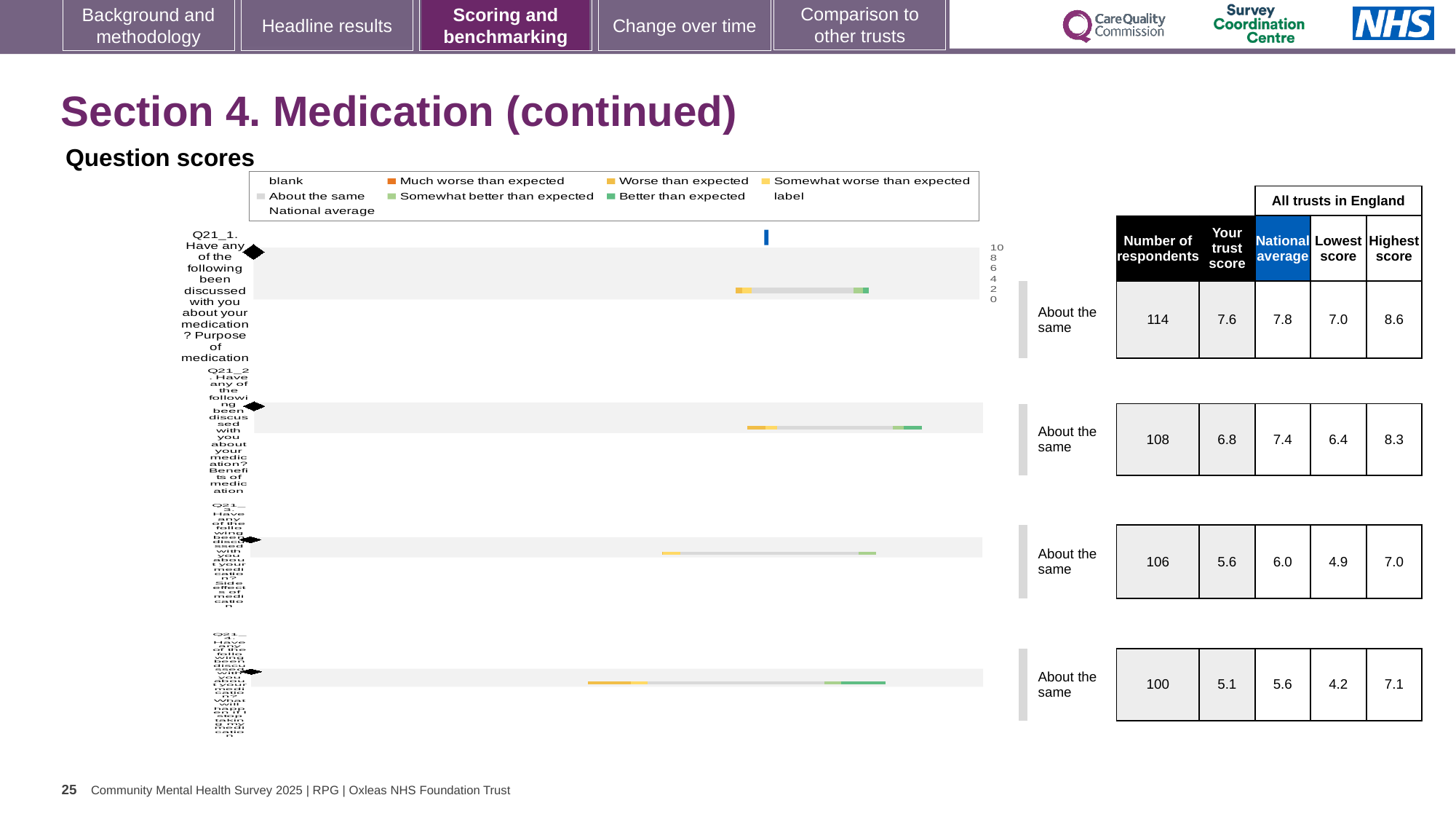
How many question bars (Q21_1 to Q21_4) are plotted in the chart? 4 What benchmark category is shown next to each of the four question bars? About the same In the table beside the chart, what is the highest score for Q21_4? 7.1 For Q21_3, which is larger in the table beside the chart: 'Your trust score' or the national average? National average In the table beside the chart, what is 'Your trust score' for Q21_2 (Benefits of medication)? 6.8 What is the difference between the national average and 'Your trust score' for Q21_2 in the table beside the chart? 0.6 Which question has the highest 'Your trust score' in the table beside the chart? Q21_1 What kind of chart is shown under 'Question scores'? bar chart In the table beside the chart, what is the lowest score for Q21_1? 7.0 In the table beside the chart, what is the national average for Q21_3? 6.0 In the table beside the chart, what is the number of respondents for Q21_1 (Purpose of medication)? 114 Which question has the lowest 'Your trust score' in the table beside the chart? Q21_4